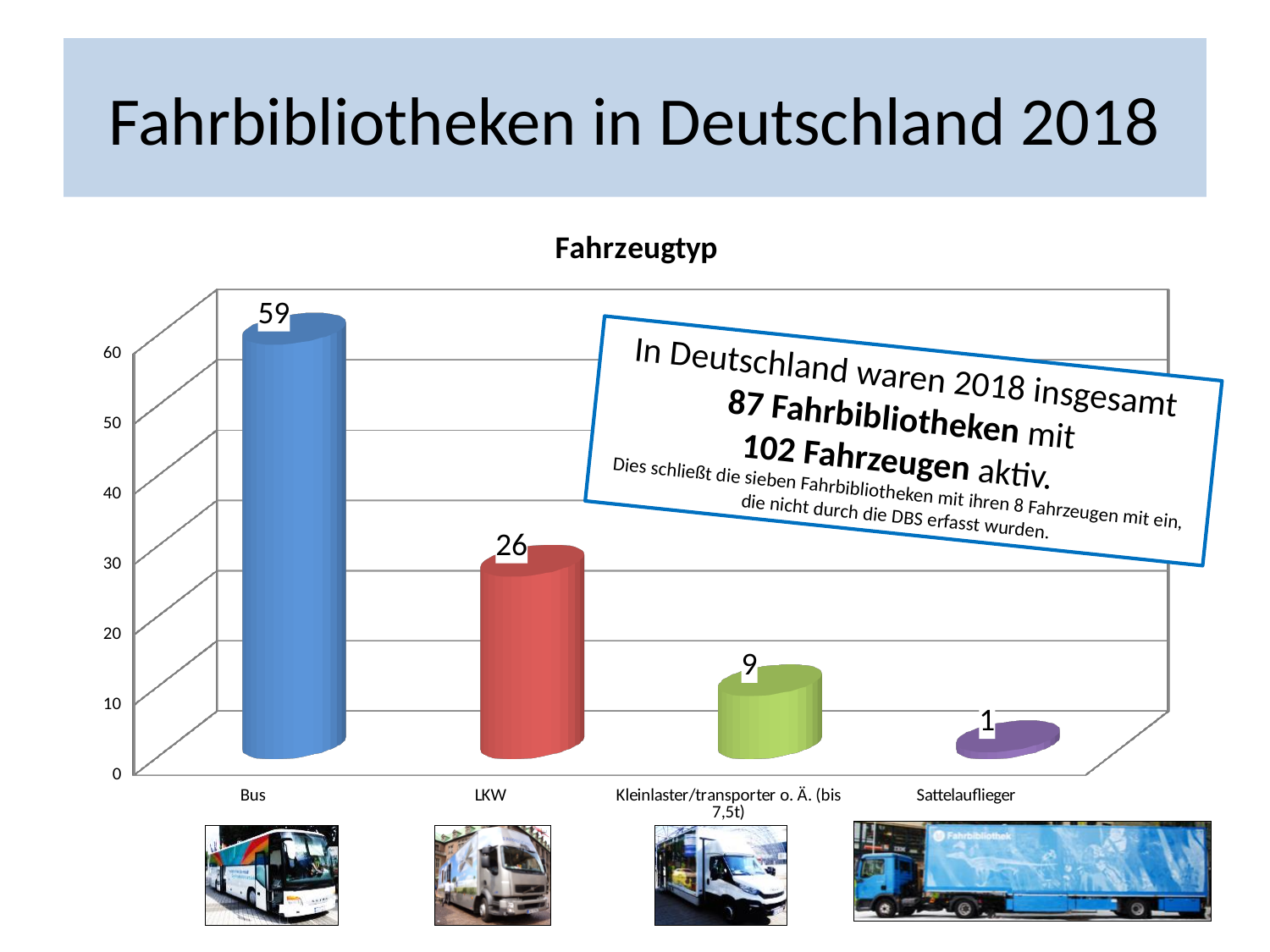
What is the title of the chart? Fahrzeugtyp What is the value for LKW? 26 What is the value for Sattelauflieger? 1 Which vehicle type has the lowest value? Sattelauflieger Which is larger, the value for LKW or the value for Kleinlaster/transporter o. Ä. (bis 7,5t)? LKW Is the value for Bus greater or less than 50? greater What is the value for Kleinlaster/transporter o. Ä. (bis 7,5t)? 9 What kind of chart is shown? bar chart Which vehicle type has the highest value? Bus What is the value for Bus? 59 How many vehicle types are shown on the x axis? 4 What is the difference between the values for Bus and LKW? 33